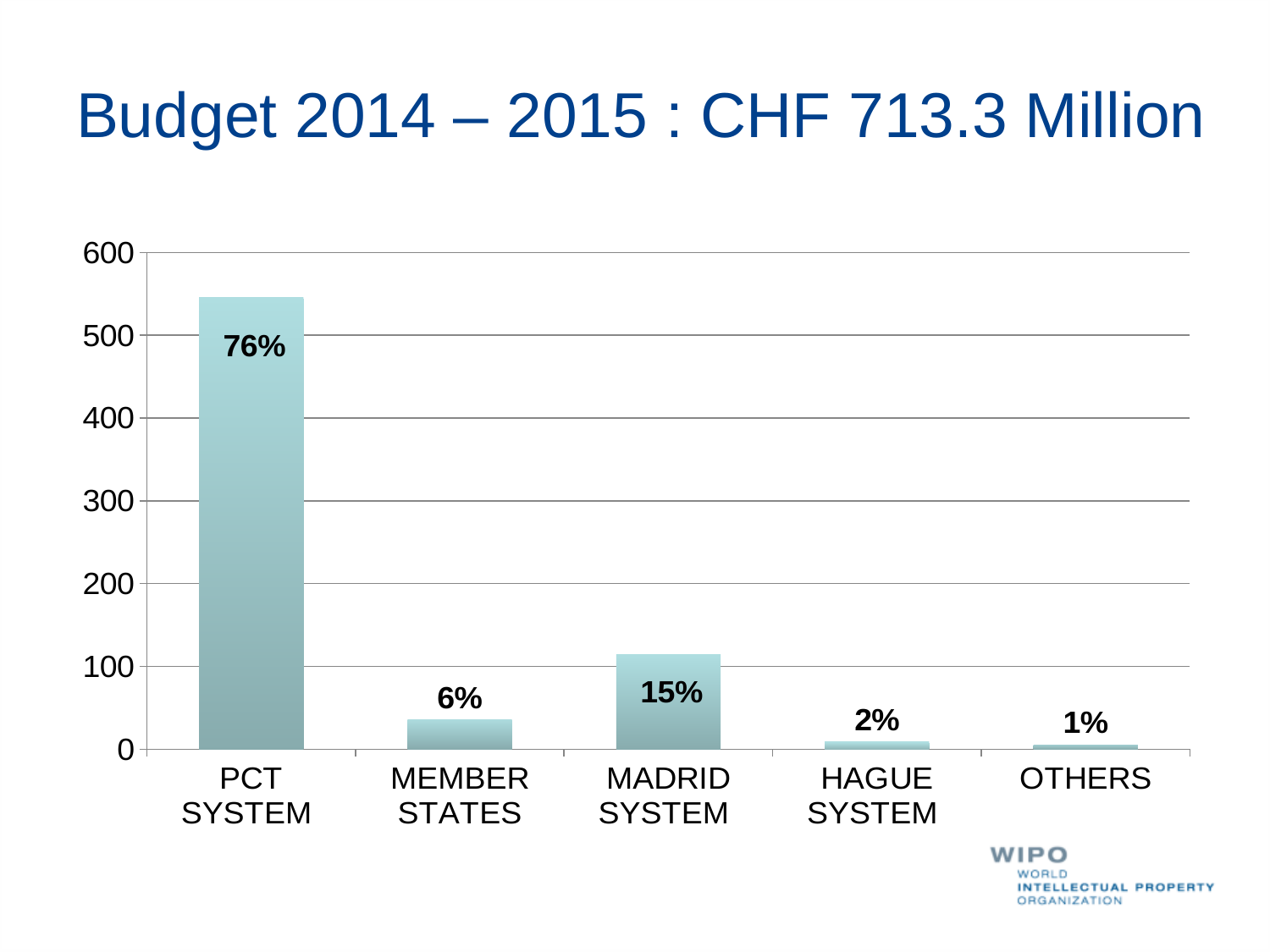
What percentage label is shown on the MADRID SYSTEM bar? 15% Is the value for PCT SYSTEM greater or less than 500? greater Which category has the lowest bar? OTHERS What kind of chart is shown on the slide? Bar chart What percentage label is shown on the HAGUE SYSTEM bar? 2% How many categories are shown on the x axis? 5 Is the value for MEMBER STATES greater or less than 100? less Which is larger, the bar for MADRID SYSTEM or the bar for MEMBER STATES? MADRID SYSTEM What is the title of the slide containing the chart? Budget 2014 – 2015 : CHF 713.3 Million What percentage label is shown on the PCT SYSTEM bar? 76% Which category has the highest bar? PCT SYSTEM What percentage label is shown on the MEMBER STATES bar? 6%